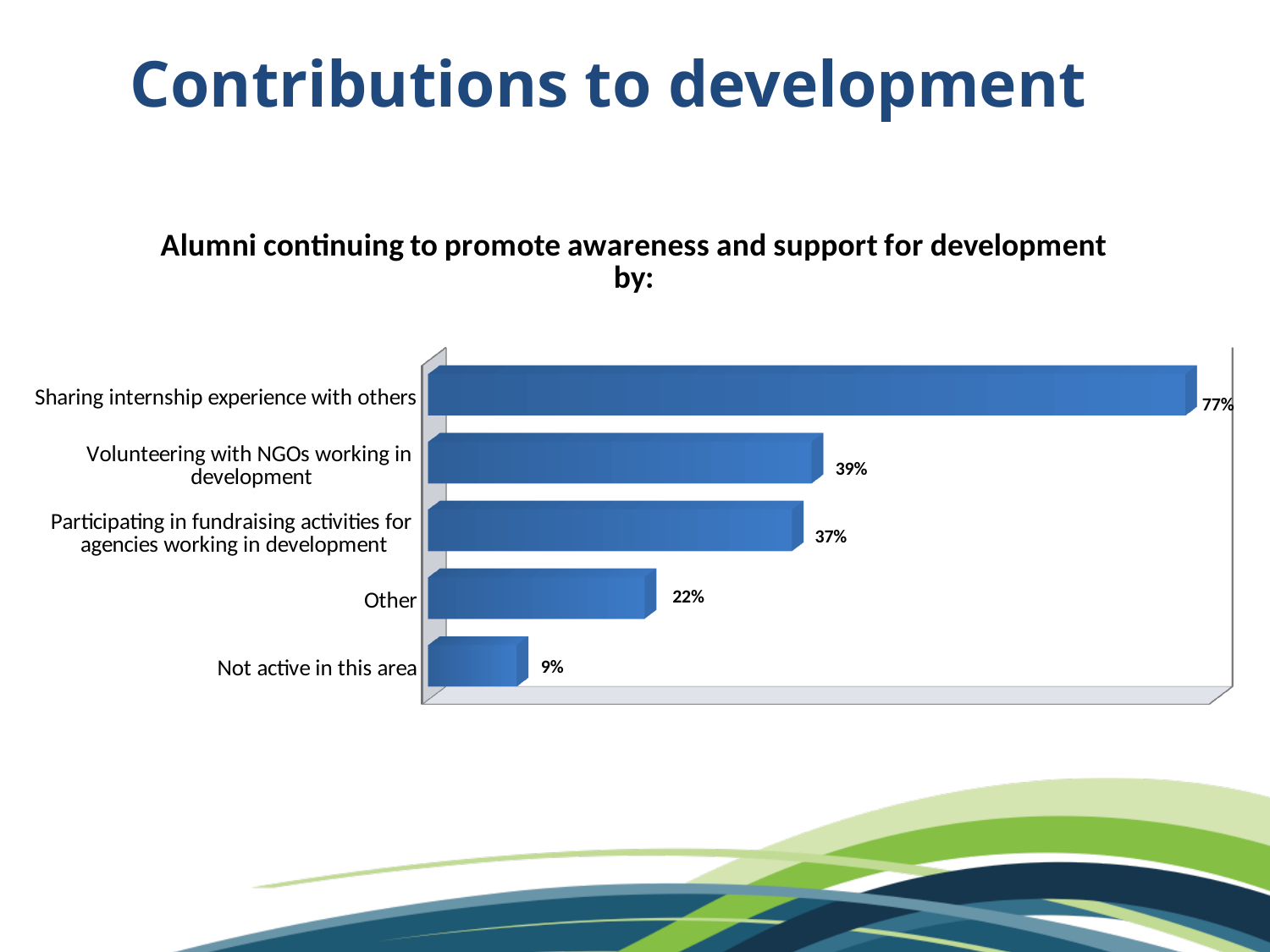
What percentage of alumni report sharing internship experience with others? 77% Which category has the highest value? Sharing internship experience with others What kind of chart is shown on the slide? Bar chart What is the value for 'Other'? 22% What is the difference between the values for 'Other' and 'Not active in this area'? 13% What is the value for 'Participating in fundraising activities for agencies working in development'? 37% How many categories are shown in the chart? 5 What is the value for 'Volunteering with NGOs working in development'? 39% What is the difference between the values for 'Sharing internship experience with others' and 'Volunteering with NGOs working in development'? 38% What percentage of alumni are 'Not active in this area'? 9% Which is larger: the value for 'Other' or the value for 'Not active in this area'? Other Which category has the lowest value? Not active in this area